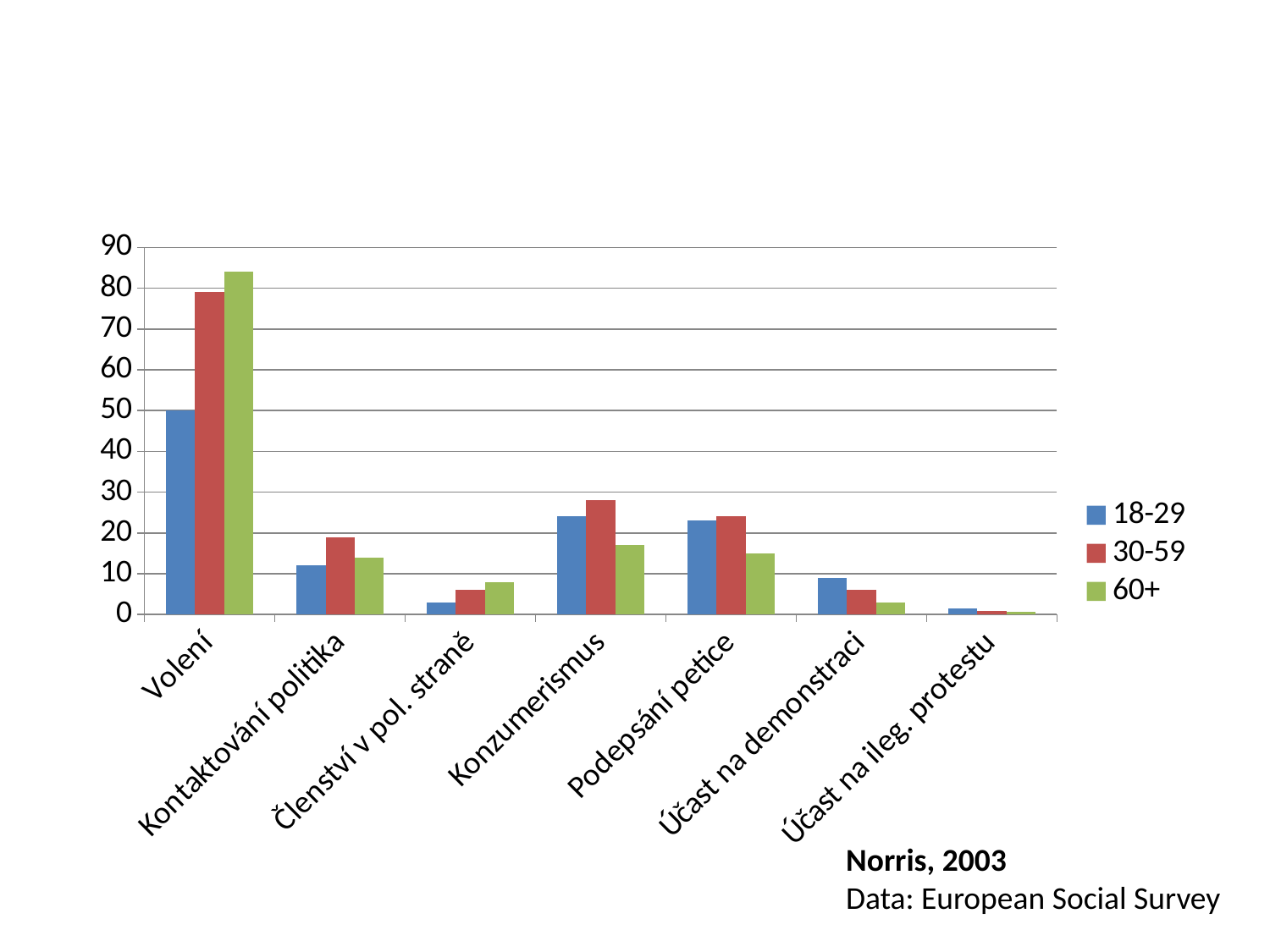
Is the value for Kontaktování politika in the 18-29 series greater or less than 10? greater How many categories are shown on the x axis of the chart? 7 What data source is cited below the chart? European Social Survey What kind of chart is shown on the slide? bar chart Which category has the highest value for the 60+ series? Volení How many series does the chart's legend list? 3 Is the value for Volení in the 30-59 series greater or less than 70? greater Is the value for Konzumerismus in the 60+ series greater or less than 20? less Which category has the lowest value for the 30-59 series? Účast na ileg. protestu Which age groups are listed in the chart's legend? 18-29, 30-59, 60+ For Volení, which series has the larger value: 18-29 or 60+? 60+ For Účast na demonstraci, which series has the larger value: 18-29 or 60+? 18-29